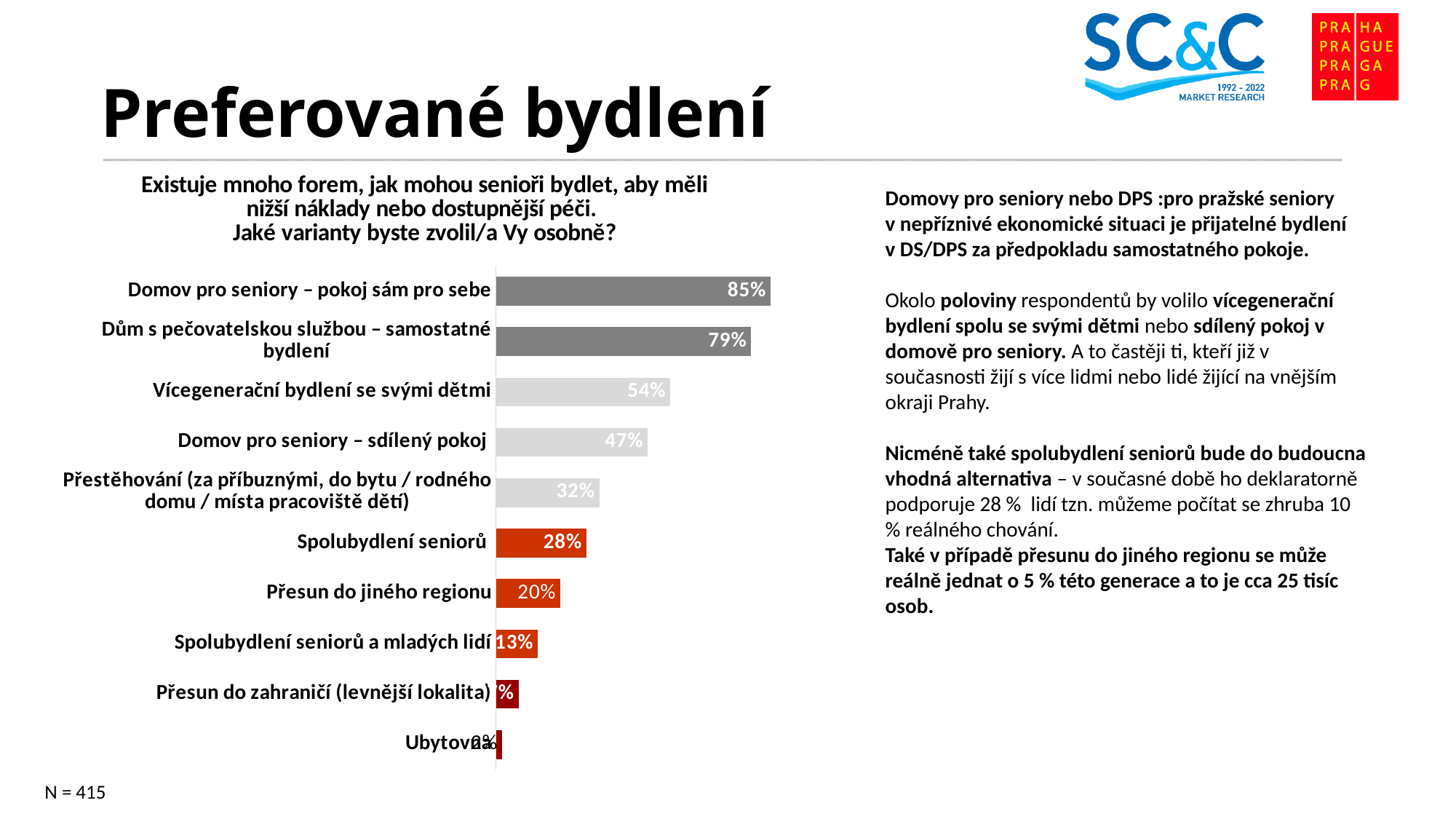
What is the value for "Domov pro seniory – pokoj sám pro sebe"? 85% What sample size (N) is stated on the slide? N = 415 Which is larger: "Spolubydlení seniorů" or "Spolubydlení seniorů a mladých lidí"? Spolubydlení seniorů What kind of chart is shown on the slide? bar chart What is the difference between "Domov pro seniory – pokoj sám pro sebe" and "Dům s pečovatelskou službou – samostatné bydlení"? 6% Which category has the highest value? Domov pro seniory – pokoj sám pro sebe What is the value for "Spolubydlení seniorů"? 28% What is the value for "Přesun do jiného regionu"? 20% What is the difference between "Vícegenerační bydlení se svými dětmi" and "Domov pro seniory – sdílený pokoj"? 7% How many categories does the chart show? 10 What is the value for "Vícegenerační bydlení se svými dětmi"? 54% What is the value for "Dům s pečovatelskou službou – samostatné bydlení"? 79%